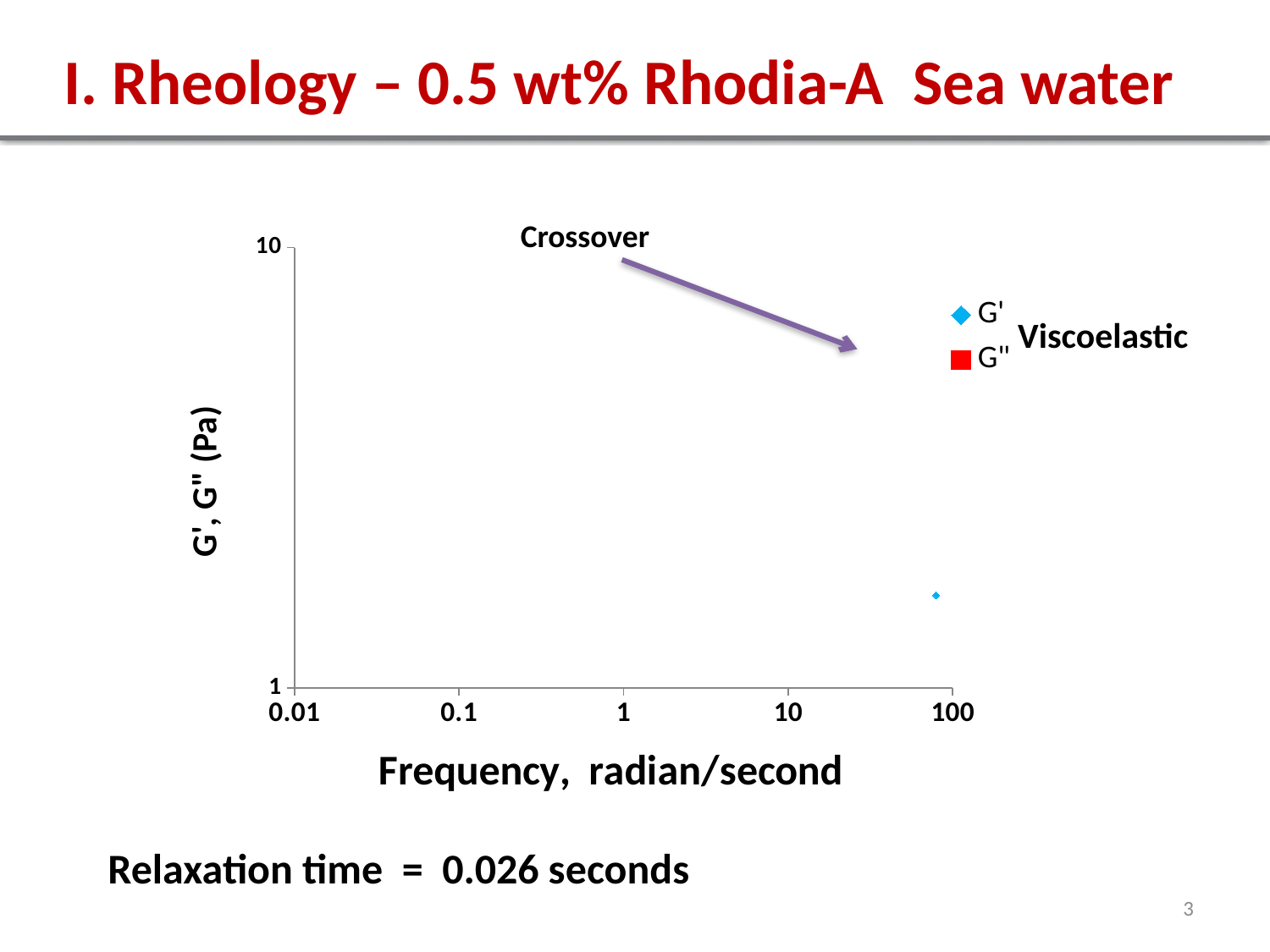
Is the frequency of the single plotted G' point greater or less than 10 radian/second? greater What is the label of the chart's x axis? Frequency, radian/second How many series does the chart legend list? 2 How many data points are visibly plotted on the chart? 1 What are the two series named in the chart legend? G' and G'' Is the value of the single plotted G' point greater or less than 10 Pa? less What kind of chart is shown on the slide? scatter chart